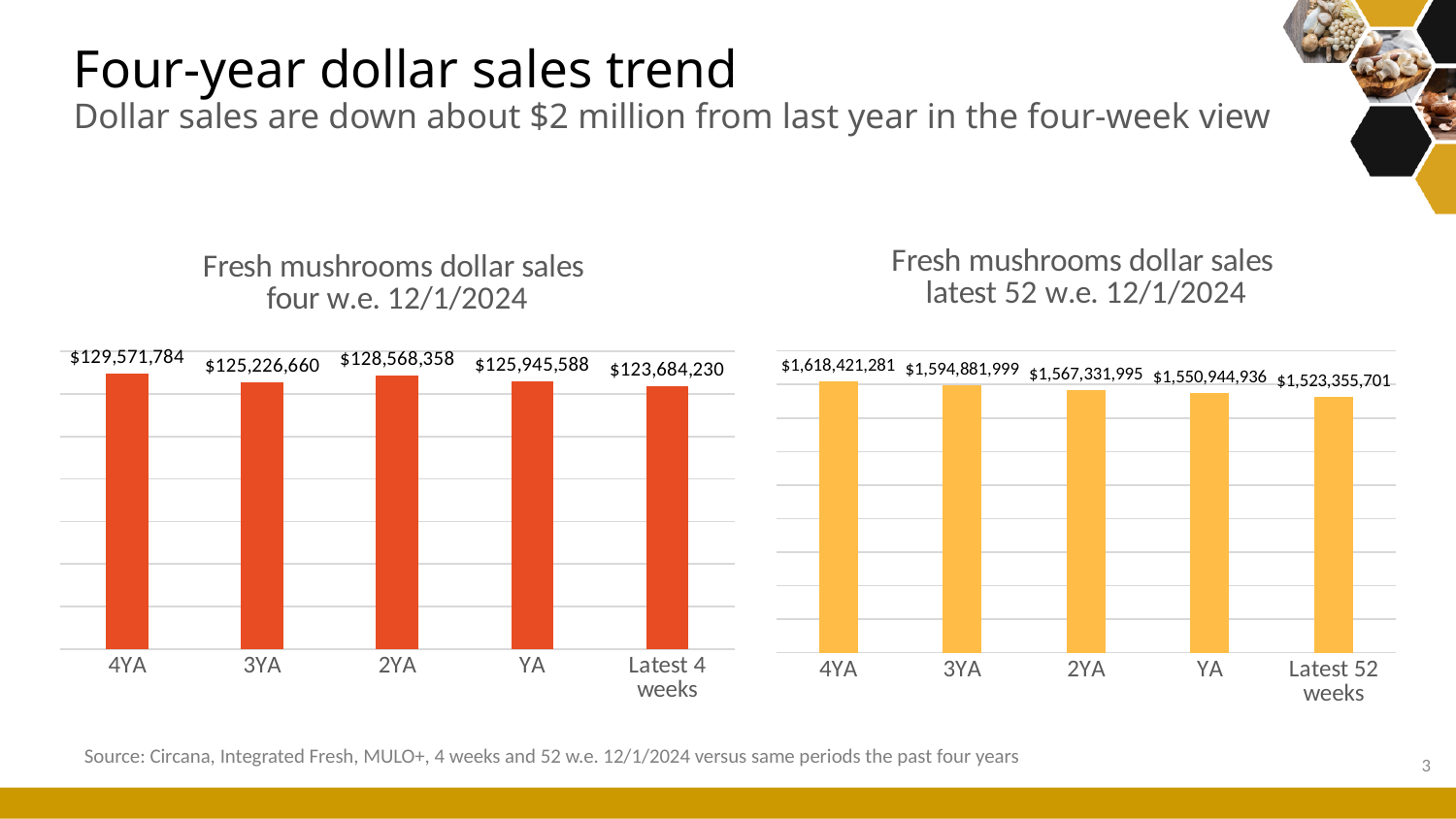
In the 'Fresh mushrooms dollar sales four w.e. 12/1/2024' chart, which period has the highest value? 4YA In the 'Fresh mushrooms dollar sales four w.e. 12/1/2024' chart, what is the difference between YA and Latest 4 weeks? $2,261,358 In the 'Fresh mushrooms dollar sales four w.e. 12/1/2024' chart, which is larger, 3YA or 2YA? 2YA How many periods are shown in the 'Fresh mushrooms dollar sales latest 52 w.e. 12/1/2024' chart? 5 In the 'Fresh mushrooms dollar sales four w.e. 12/1/2024' chart, which period has the lowest value? Latest 4 weeks In the 'Fresh mushrooms dollar sales latest 52 w.e. 12/1/2024' chart, which period has the lowest value? Latest 52 weeks In the 'Fresh mushrooms dollar sales latest 52 w.e. 12/1/2024' chart, what is the value for YA? $1,550,944,936 In the 'Fresh mushrooms dollar sales four w.e. 12/1/2024' chart, what is the value for Latest 4 weeks? $123,684,230 In the 'Fresh mushrooms dollar sales latest 52 w.e. 12/1/2024' chart, what is the difference between 4YA and Latest 52 weeks? $95,065,580 In the 'Fresh mushrooms dollar sales latest 52 w.e. 12/1/2024' chart, what is the value for Latest 52 weeks? $1,523,355,701 In the 'Fresh mushrooms dollar sales four w.e. 12/1/2024' chart, what is the value for 2YA? $128,568,358 In the 'Fresh mushrooms dollar sales latest 52 w.e. 12/1/2024' chart, do the values rise or fall from 4YA to Latest 52 weeks? fall